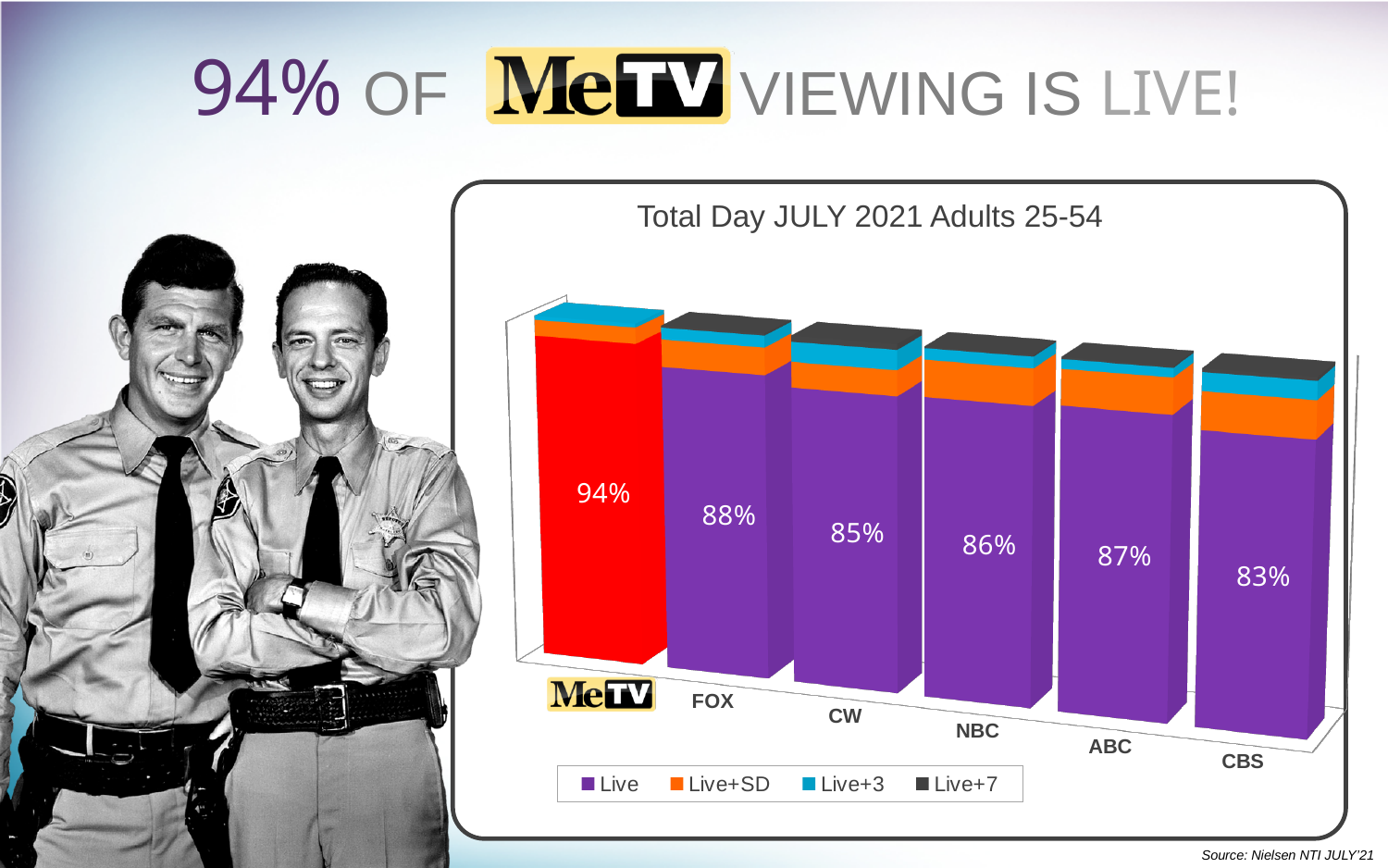
What is the difference between the Live share for ABC and CBS? 4% What kind of chart is shown on the slide? Stacked bar chart Which network has the lowest Live share? CBS Which has a larger Live share, CW or ABC? ABC How many networks are shown in the chart? 6 What is the Live share for CBS? 83% What is the difference between the Live share for MeTV and FOX? 6% Which network has the highest Live share? MeTV How many series does the legend list? 4 What is the title of the chart? Total Day JULY 2021 Adults 25-54 What is the Live share for NBC? 86% What is the Live share for MeTV? 94%